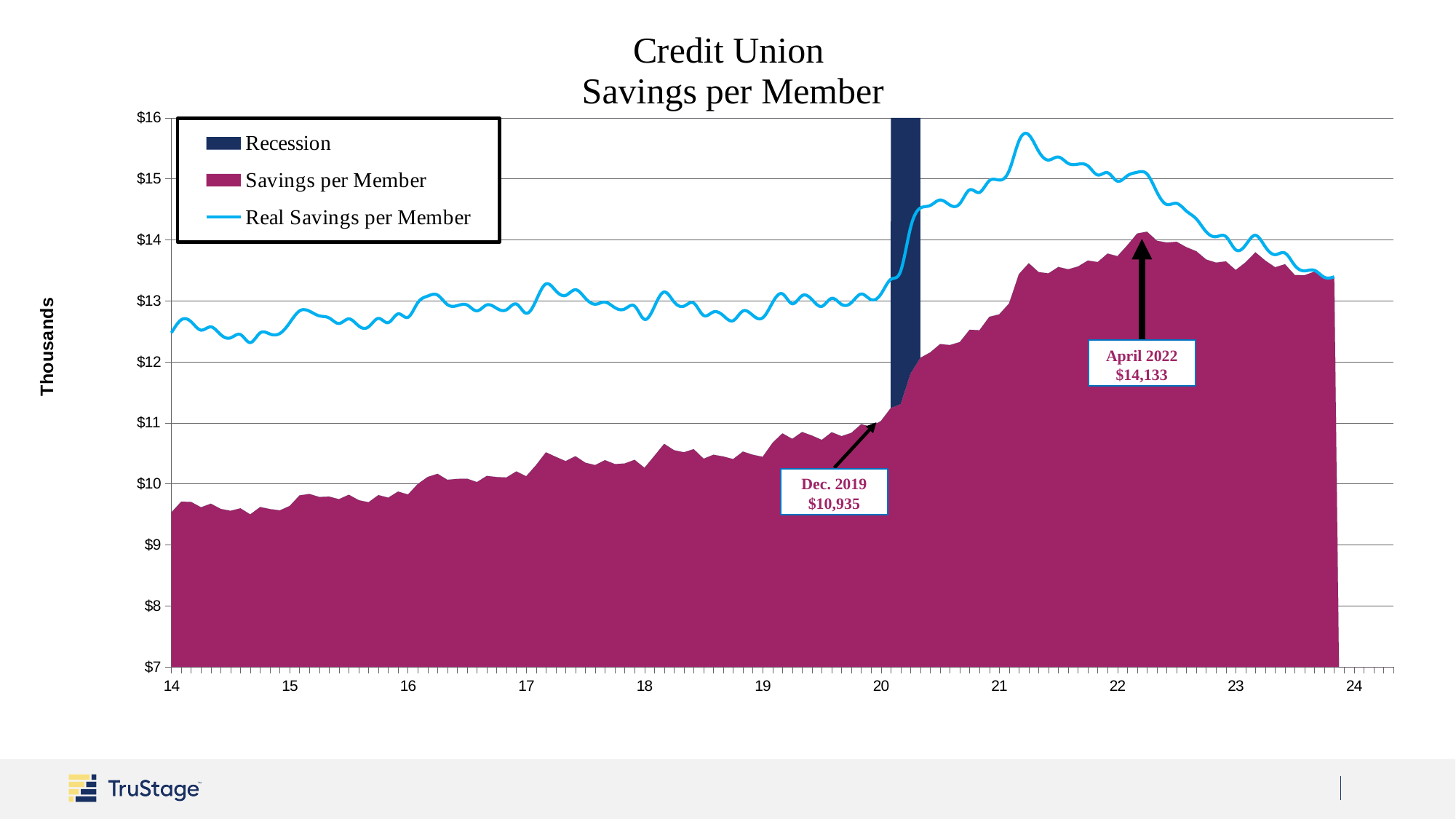
Which of the two annotated points, Dec. 2019 or April 2022, has the higher Savings per Member value? April 2022 How many series does the legend list? 3 What is the Savings per Member value annotated for April 2022? $14,133 Does Savings per Member rise or fall from 2014 to 2022? Rise What kind of chart is this? Area chart with a line series What is the Savings per Member value annotated for Dec. 2019? $10,935 What is the label on the vertical axis? Thousands What is the difference between the annotated April 2022 value and the annotated Dec. 2019 value? $3,198 What is the title of the chart? Credit Union Savings per Member Is the Savings per Member value at the start of 2014 greater or less than $10 thousand? less At the start of 2014, which is larger: Real Savings per Member or Savings per Member? Real Savings per Member Is the peak of Real Savings per Member in 2021 greater or less than $15 thousand? greater